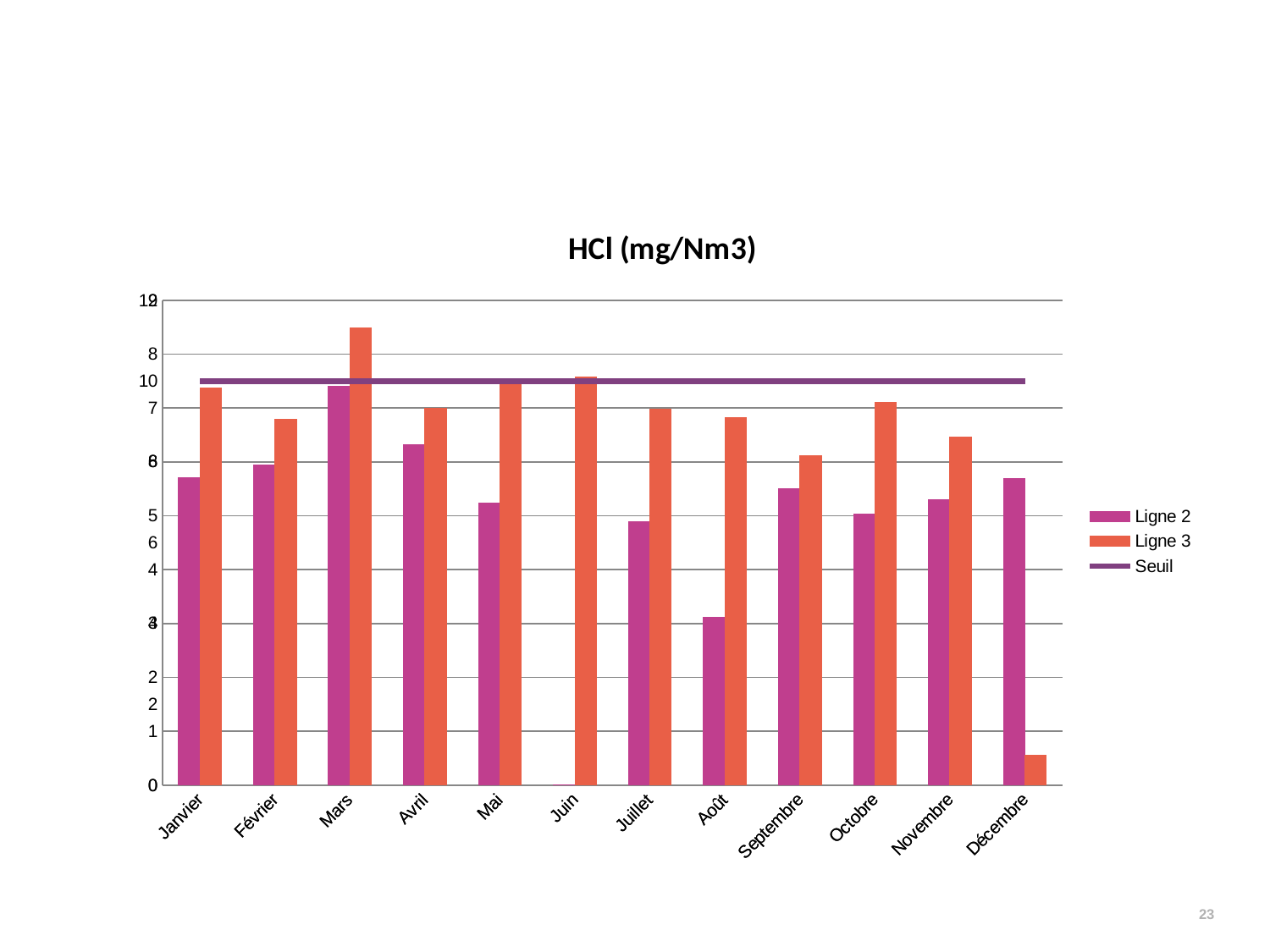
What is the title of the chart? HCl (mg/Nm3) In which month is the Ligne 2 value highest? Mars In Janvier, which is larger, Ligne 2 or Ligne 3? Ligne 3 In Décembre, which is larger, Ligne 2 or Ligne 3? Ligne 2 Which series is drawn as a horizontal line rather than bars? Seuil In which month is the Ligne 3 value highest? Mars How many months are shown on the x axis? 12 In which month is the Ligne 3 value lowest? Décembre How many series does the legend list? 3 What kind of chart is shown on the slide? bar chart